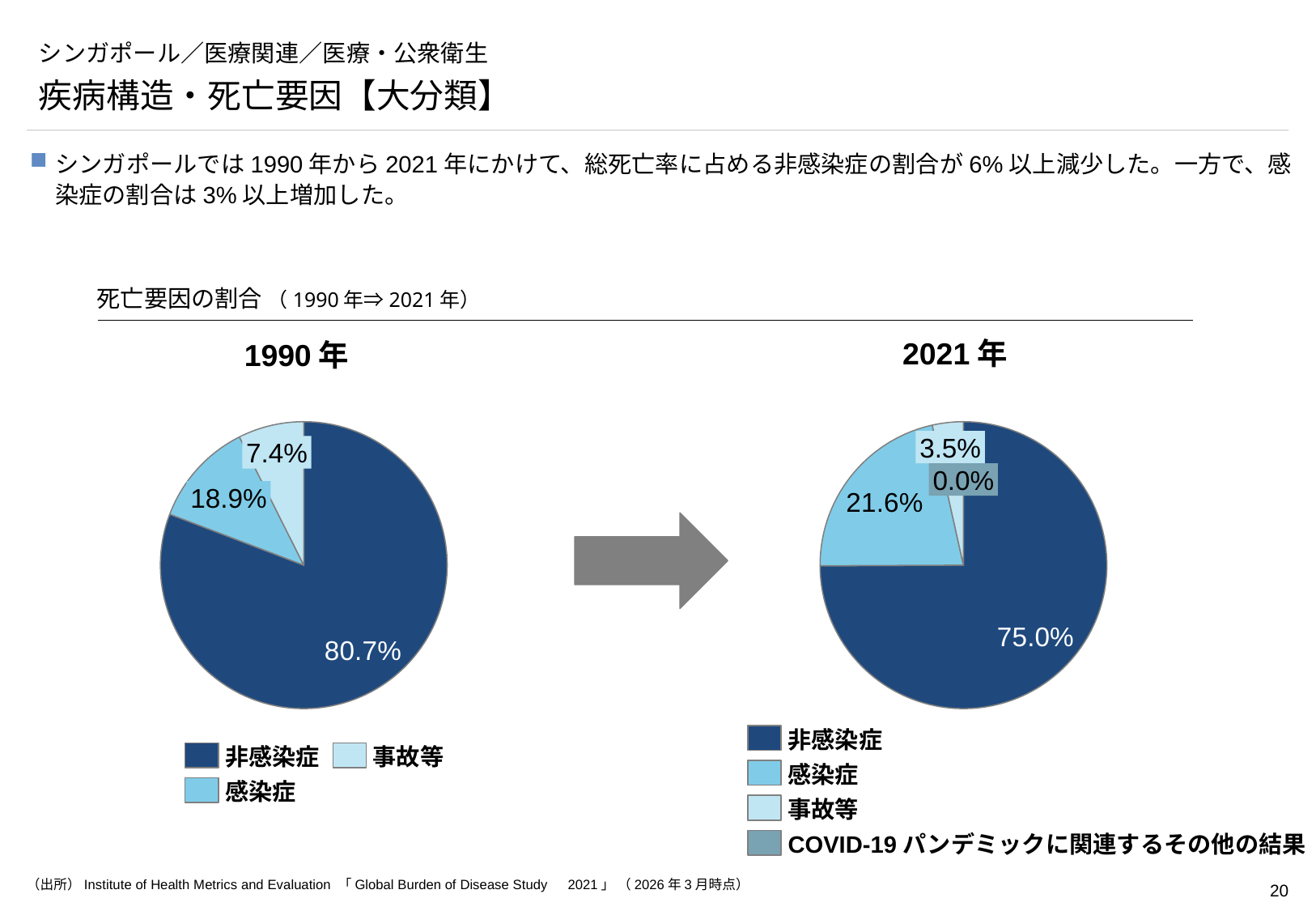
In the 2021年 pie chart, what share is shown for 非感染症? 75.0% In the 2021年 pie chart, what share is shown for COVID-19 パンデミックに関連するその他の結果? 0.0% What type of chart is used to show the 1990年 data? Pie chart In the 1990年 pie chart, what share is shown for 非感染症? 80.7% Comparing the two pie charts, is the share of 非感染症 larger in 1990年 or in 2021年? 1990年 What is the difference between the 非感染症 share in the 1990年 pie chart and in the 2021年 pie chart? 5.7% How many categories does the legend of the 2021年 pie chart list? 4 In the 1990年 pie chart, what share is shown for 事故等? 7.4% In the 2021年 pie chart, what share is shown for 感染症? 21.6% In the 1990年 pie chart, what share is shown for 感染症? 18.9% In the 2021年 pie chart, which category has the largest share? 非感染症 In the 2021年 pie chart, which category has the smallest share? COVID-19 パンデミックに関連するその他の結果